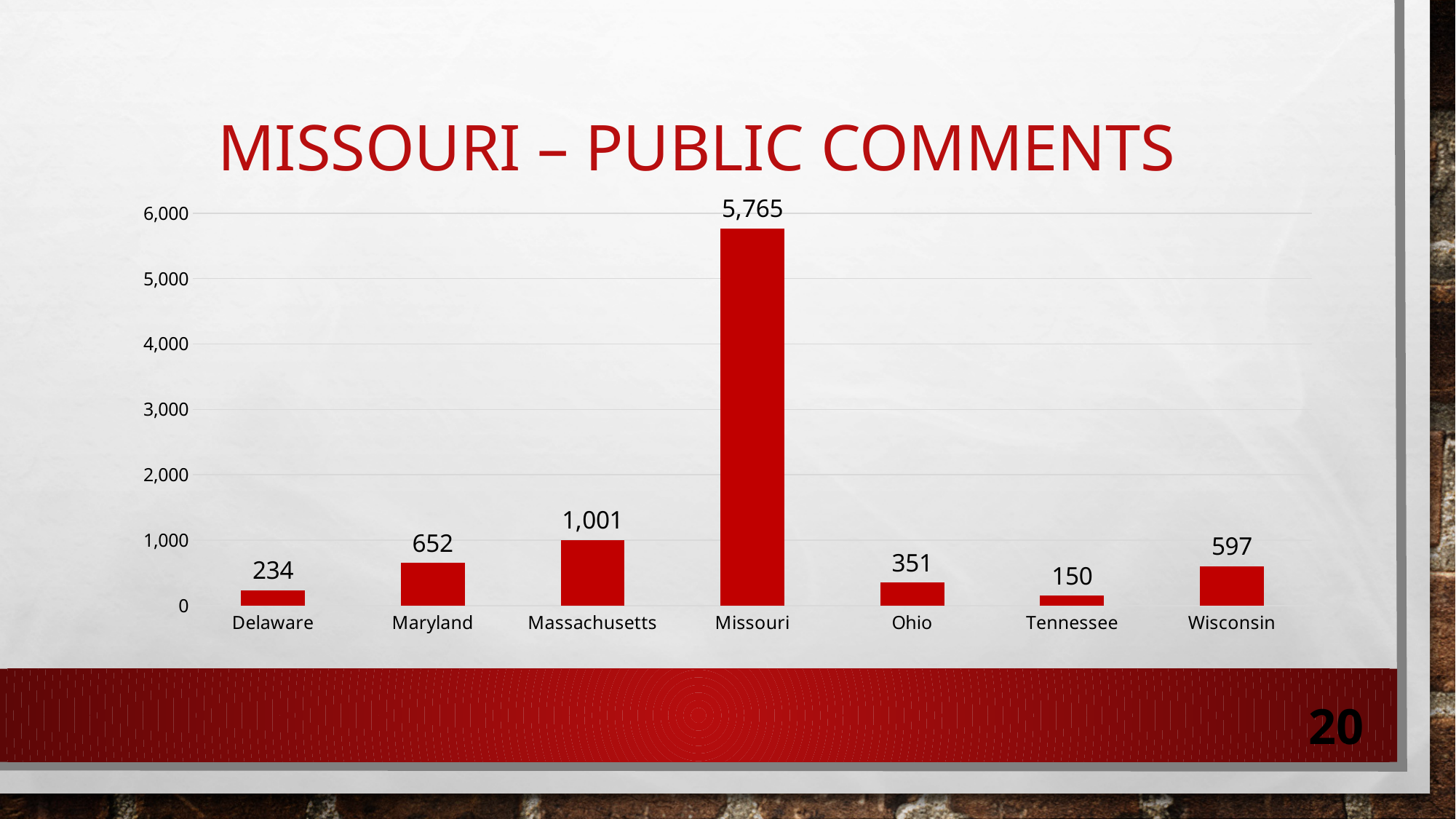
What is the difference between the values for Missouri and Massachusetts? 4,764 What is the value for Massachusetts? 1,001 Which state has the highest value? Missouri What kind of chart is shown on the slide? bar chart How many states are shown on the chart? 7 Which is larger, the value for Ohio or the value for Delaware? Ohio Which state has the lowest value? Tennessee What is the value for Tennessee? 150 What is the title of the slide? Missouri – Public Comments Is the value for Massachusetts greater or less than 1,000? greater What is the difference between the values for Maryland and Wisconsin? 55 What is the value for Missouri? 5,765